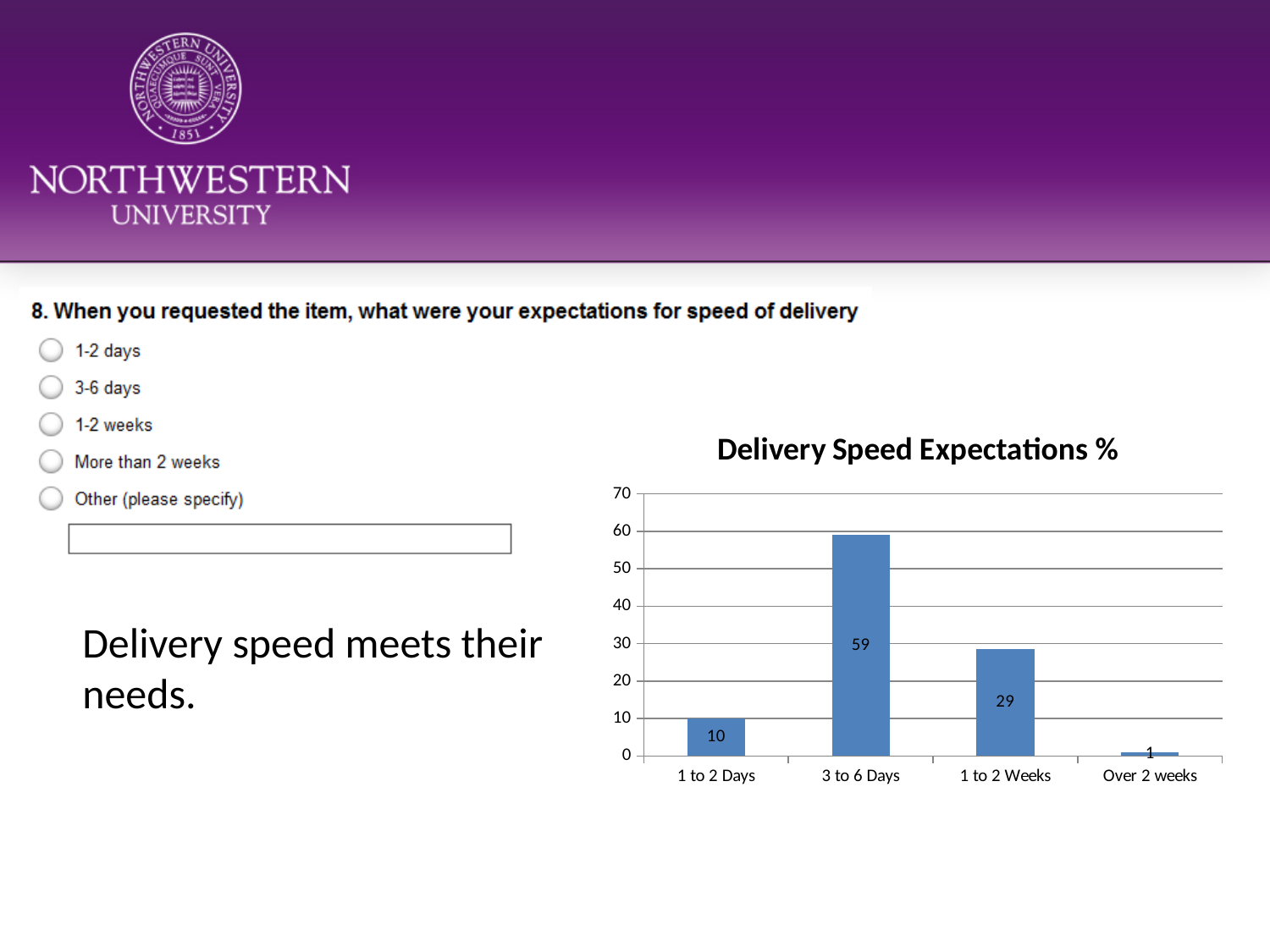
Which category has the highest value in the Delivery Speed Expectations % chart? 3 to 6 Days How many categories are shown in the Delivery Speed Expectations % chart? 4 What is the value for 3 to 6 Days in the Delivery Speed Expectations % chart? 59 Which category has the lowest value in the Delivery Speed Expectations % chart? Over 2 weeks What is the value for Over 2 weeks in the Delivery Speed Expectations % chart? 1 Is the value for 3 to 6 Days in the Delivery Speed Expectations % chart greater or less than 50? greater What kind of chart is the Delivery Speed Expectations % chart? bar chart Which is larger in the Delivery Speed Expectations % chart: 1 to 2 Days or 1 to 2 Weeks? 1 to 2 Weeks What is the value for 1 to 2 Days in the Delivery Speed Expectations % chart? 10 What is the title of the chart on the slide? Delivery Speed Expectations % What is the difference between the values for 3 to 6 Days and 1 to 2 Weeks in the Delivery Speed Expectations % chart? 30 What is the value for 1 to 2 Weeks in the Delivery Speed Expectations % chart? 29